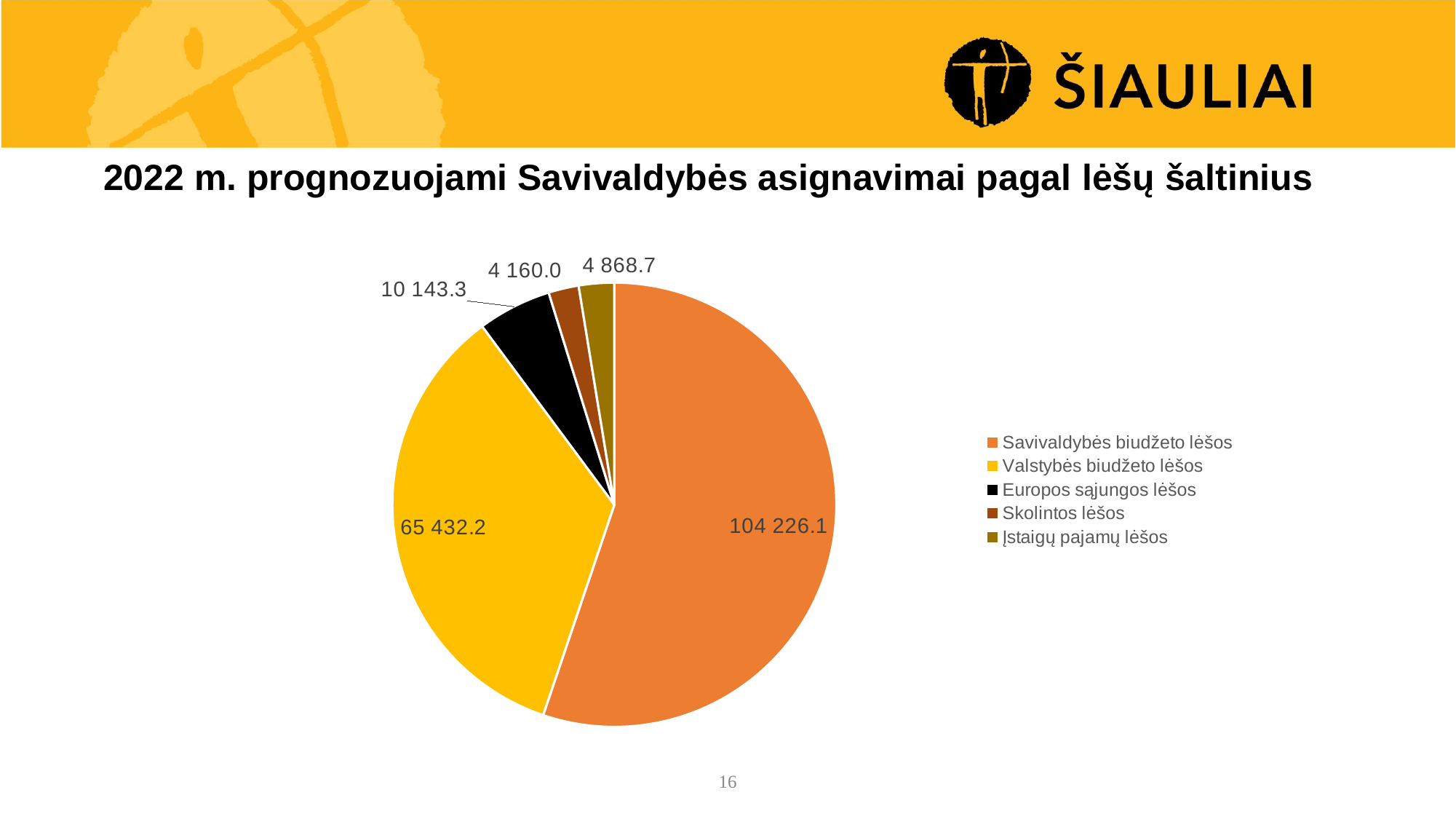
Which funding source has the smallest slice of the pie? Skolintos lėšos What is the value for Valstybės biudžeto lėšos? 65 432.2 How many slices does the pie chart have? 5 What is the value for Europos sąjungos lėšos? 10 143.3 What is the title of the chart on the slide? 2022 m. prognozuojami Savivaldybės asignavimai pagal lėšų šaltinius What is the value for Savivaldybės biudžeto lėšos? 104 226.1 What is the value for Įstaigų pajamų lėšos? 4 868.7 What is the difference between Savivaldybės biudžeto lėšos and Valstybės biudžeto lėšos? 38 793.9 Which funding source has the largest slice of the pie? Savivaldybės biudžeto lėšos What type of chart is shown on the slide? Pie chart What is the value for Skolintos lėšos? 4 160.0 Which is larger: Skolintos lėšos or Įstaigų pajamų lėšos? Įstaigų pajamų lėšos